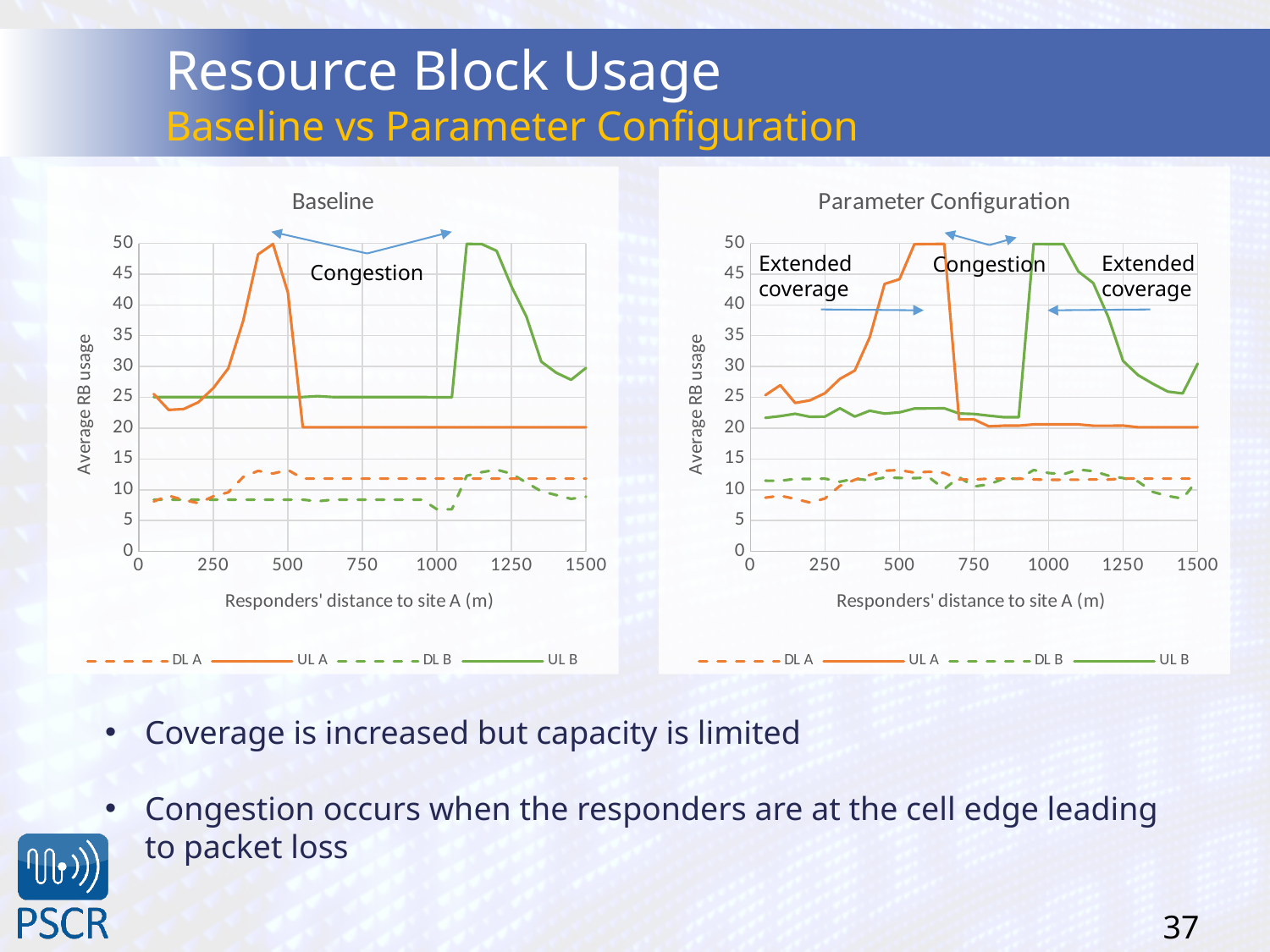
What is the x-axis title of the Baseline chart? Responders' distance to site A (m) In the Baseline chart, is the value of DL A at 1000 m greater or less than 15? less In the Parameter Configuration chart, is the value of UL A at 600 m greater or less than 40? greater How many series does the legend of the Baseline chart list? 4 How many series does the legend of the Parameter Configuration chart list? 4 What kind of chart is the Baseline chart? line chart In the Baseline chart, at 1500 m, which series has the larger value, UL A or UL B? UL B In the Parameter Configuration chart, is the value of UL B at 1000 m greater or less than 40? greater What is the y-axis title of the Parameter Configuration chart? Average RB usage In the Baseline chart, at 450 m, which series has the larger value, UL A or UL B? UL A